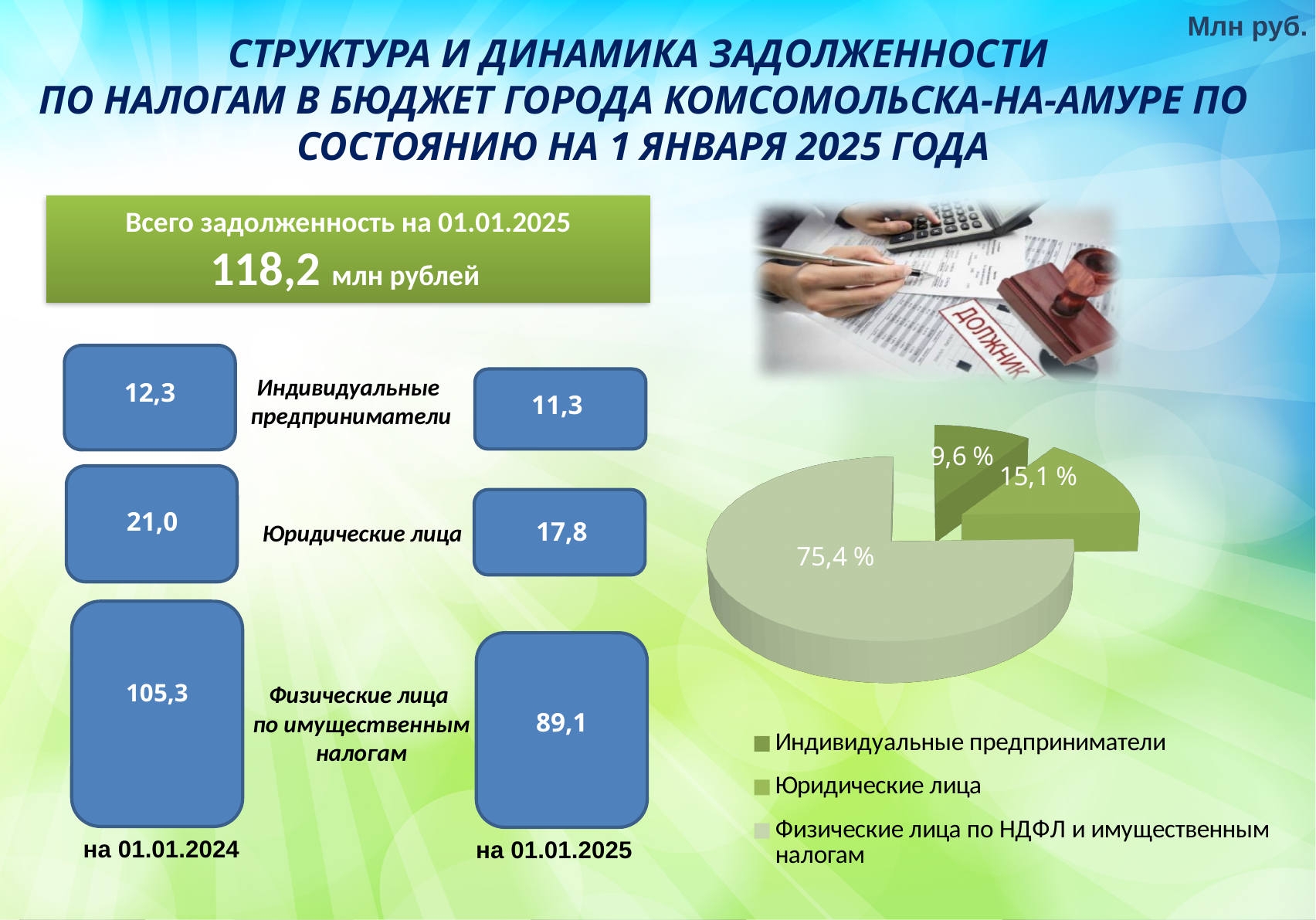
In the pie chart, what share is shown for Физические лица по НДФЛ и имущественным налогам? 75,4 % How many entries does the pie chart legend list? 3 What kind of chart is shown on the right side of the slide? pie chart In the pie chart, what share is shown for Индивидуальные предприниматели? 9,6 % Which category has the largest slice in the pie chart? Физические лица по НДФЛ и имущественным налогам In the pie chart, what is the difference in percentage points between the Физические лица slice and the Юридические лица slice? 60,3 % Which category has the smallest slice in the pie chart? Индивидуальные предприниматели In the pie chart, what is the difference in percentage points between the Юридические лица slice and the Индивидуальные предприниматели slice? 5,5 % In the pie chart, which slice is larger: Юридические лица or Индивидуальные предприниматели? Юридические лица In the pie chart, what share is shown for Юридические лица? 15,1 % How many slices does the pie chart have? 3 Which legend entry in the pie chart is shown in the lightest colour? Физические лица по НДФЛ и имущественным налогам